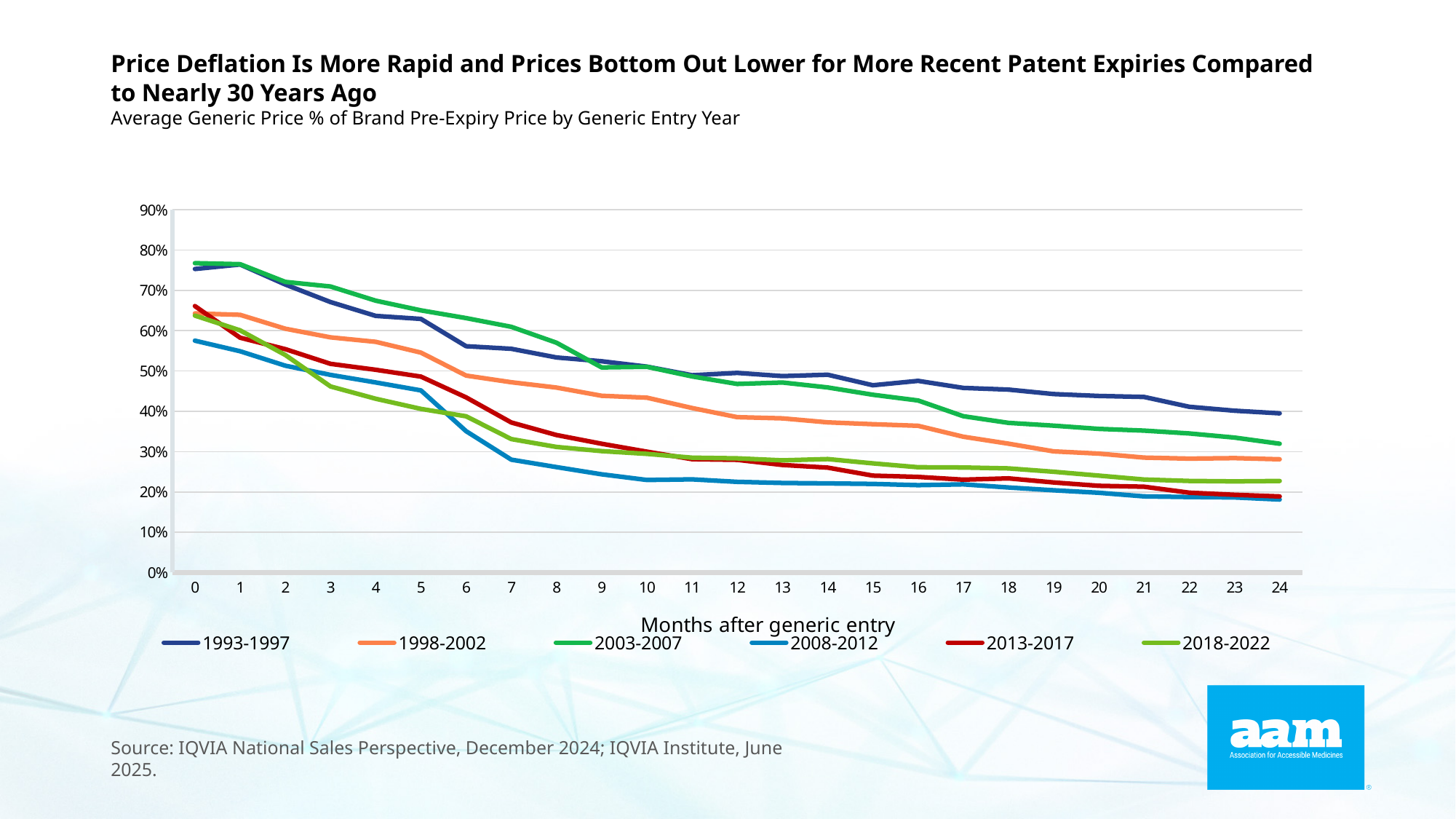
At month 24, which series has the higher value: 1993-1997 or 2008-2012? 1993-1997 Is the value for 2003-2007 at month 0 greater or less than 70%? greater How many series does the legend list? 6 Is the value for 1993-1997 at month 24 greater or less than 30%? greater Is the value for 2008-2012 at month 7 greater or less than 30%? less How many month values are plotted along the x axis? 25 Do the values for the 1993-1997 series rise or fall as months after generic entry increase? fall What is the label of the x axis? Months after generic entry Which series has the lowest value at month 7? 2008-2012 What kind of chart is shown on the slide? line chart Which series has the highest value at month 24? 1993-1997